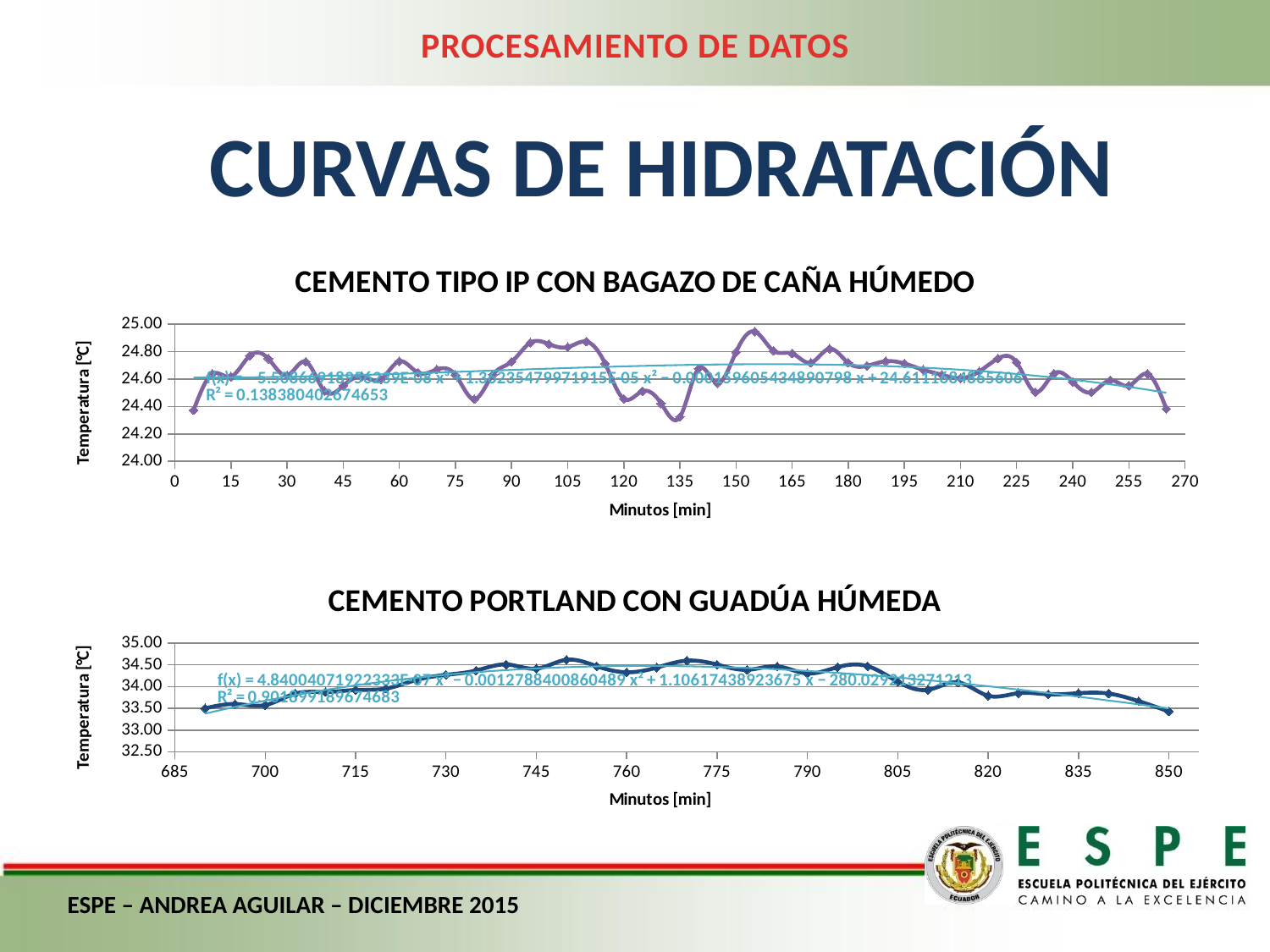
What is the y-axis title of the 'CEMENTO TIPO IP CON BAGAZO DE CAÑA HÚMEDO' chart? Temperatura [°C] In the 'CEMENTO PORTLAND CON GUADÚA HÚMEDA' chart, which is higher: the temperature at 770 minutes or at 850 minutes? 770 minutes What kind of chart is the 'CEMENTO PORTLAND CON GUADÚA HÚMEDA' chart? Line chart In the 'CEMENTO TIPO IP CON BAGAZO DE CAÑA HÚMEDO' chart, is the temperature at 5 minutes greater or less than 24.60? less In the 'CEMENTO TIPO IP CON BAGAZO DE CAÑA HÚMEDO' chart, is the temperature at 135 minutes greater or less than 24.40? less In the 'CEMENTO TIPO IP CON BAGAZO DE CAÑA HÚMEDO' chart, is the peak temperature near 155 minutes greater or less than 24.80? greater In the 'CEMENTO TIPO IP CON BAGAZO DE CAÑA HÚMEDO' chart, which is higher: the temperature at 155 minutes or at 135 minutes? 155 minutes What kind of chart is the 'CEMENTO TIPO IP CON BAGAZO DE CAÑA HÚMEDO' chart? Line chart What R² value is printed on the 'CEMENTO TIPO IP CON BAGAZO DE CAÑA HÚMEDO' chart? 0.138380402674653 In the 'CEMENTO PORTLAND CON GUADÚA HÚMEDA' chart, does the temperature rise or fall between 690 and 760 minutes? rise